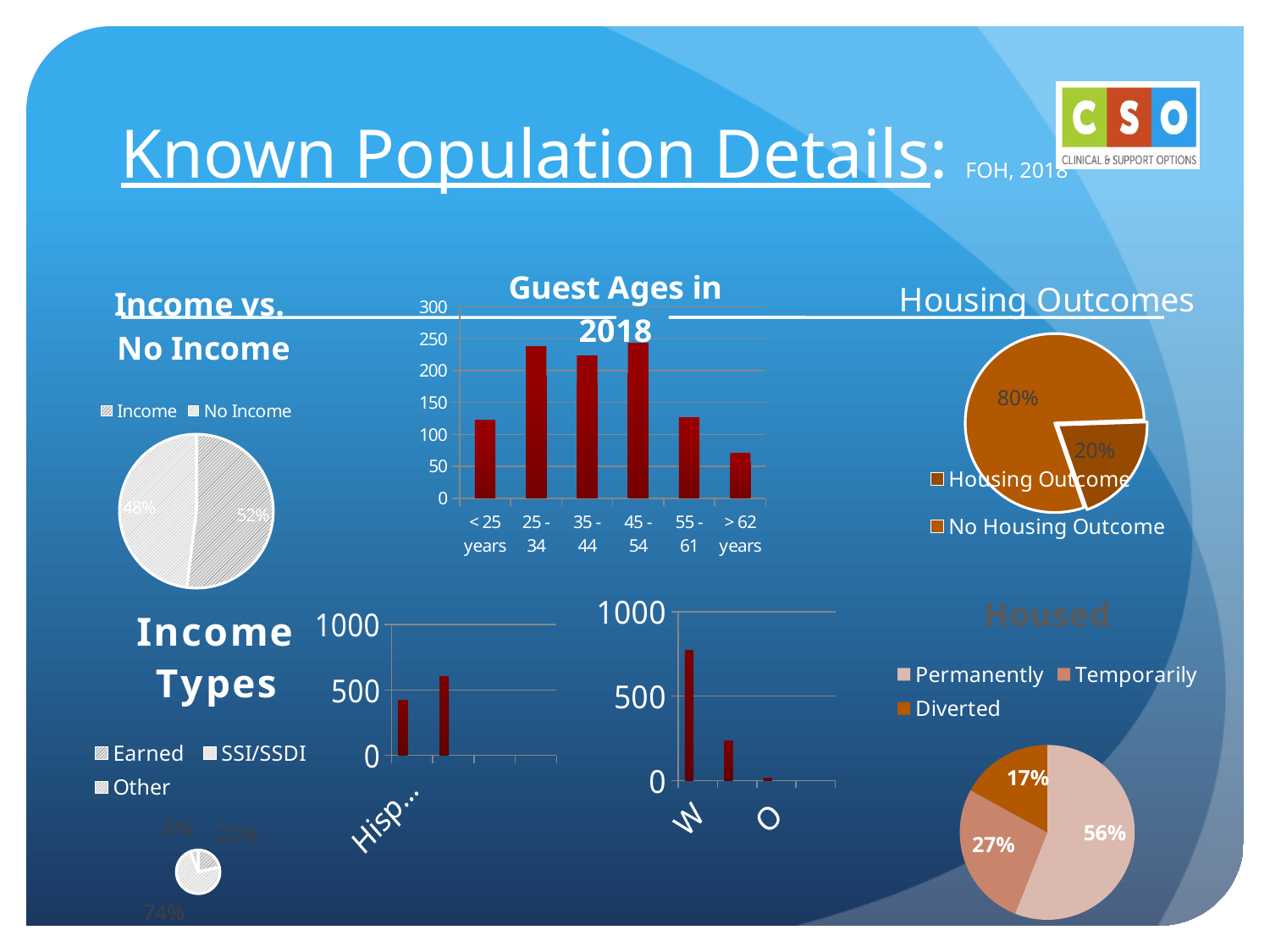
In the Guest Ages in 2018 chart, is the value for 25 - 34 greater or less than 200? greater How many age categories are shown in the Guest Ages in 2018 chart? 6 In the Housed pie chart, what is the difference in percentage points between Permanently and Temporarily? 29 percentage points In the Guest Ages in 2018 chart, which age category has the lowest value? > 62 years What kind of chart is the Guest Ages in 2018 chart? Bar chart In the Income vs. No Income pie chart, which slice is larger, Income or No Income? Income In the Housed pie chart, what percentage is shown for Permanently? 56% In the Income vs. No Income pie chart, what percentage is shown for No Income? 48% In the Housed pie chart, which category has the smallest share? Diverted In the Housing Outcomes pie chart, what share is labelled for No Housing Outcome? 80% In the Guest Ages in 2018 chart, is the value for < 25 years greater or less than 150? less In the Housing Outcomes pie chart, what share is labelled for Housing Outcome? 20%